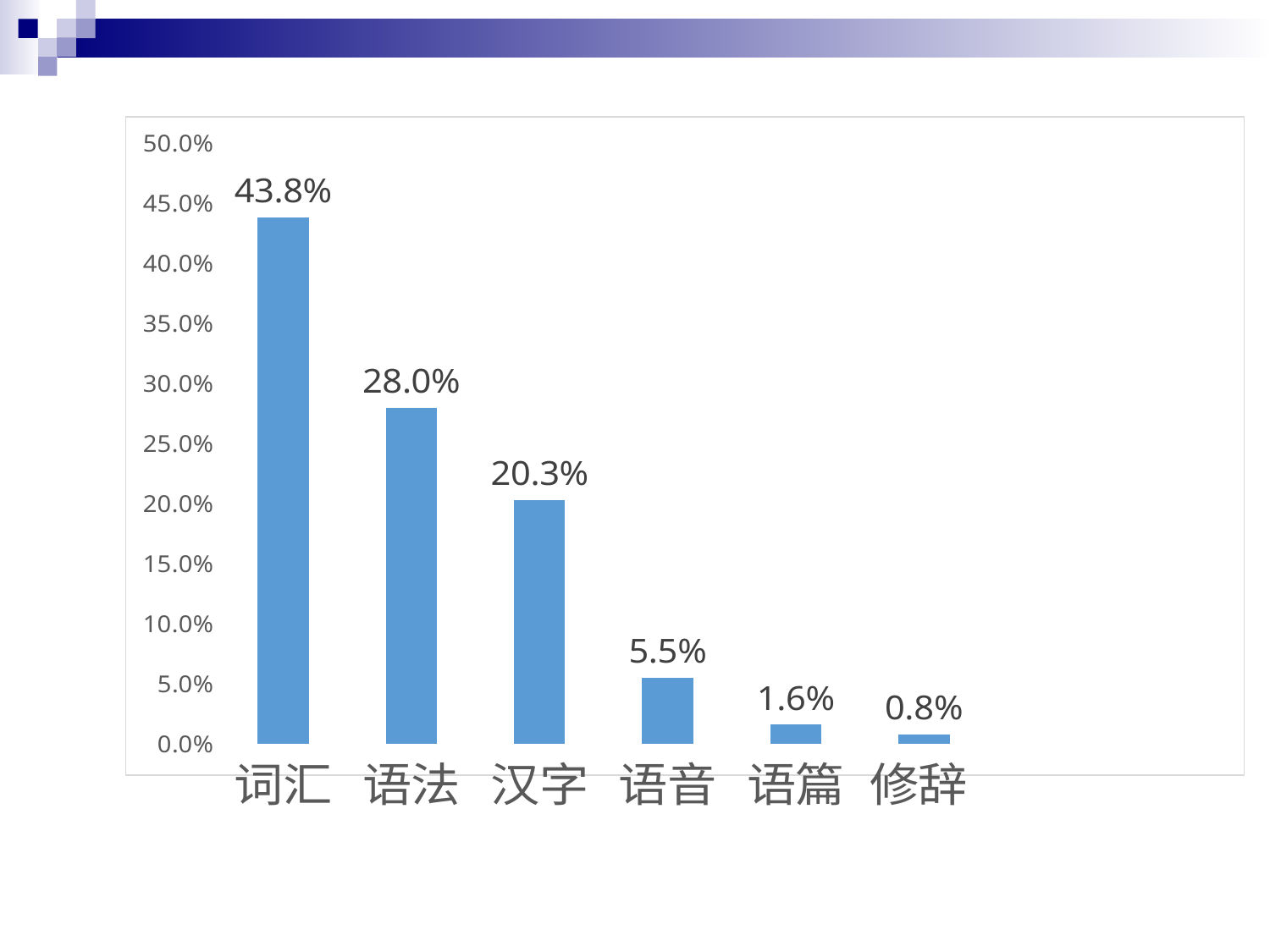
What is the value for 汉字? 20.3% What is the value for 语音? 5.5% What is the value for 词汇? 43.8% What kind of chart is shown on the slide? bar chart What is the value for 修辞? 0.8% Do the values rise or fall from left to right along the x axis? fall What is the difference between the values for 词汇 and 语法? 15.8% Which category has the highest value? 词汇 Which category has the lowest value? 修辞 Which is larger, the value for 语音 or the value for 语篇? 语音 How many categories are shown on the x axis? 6 What is the value for 语法? 28.0%